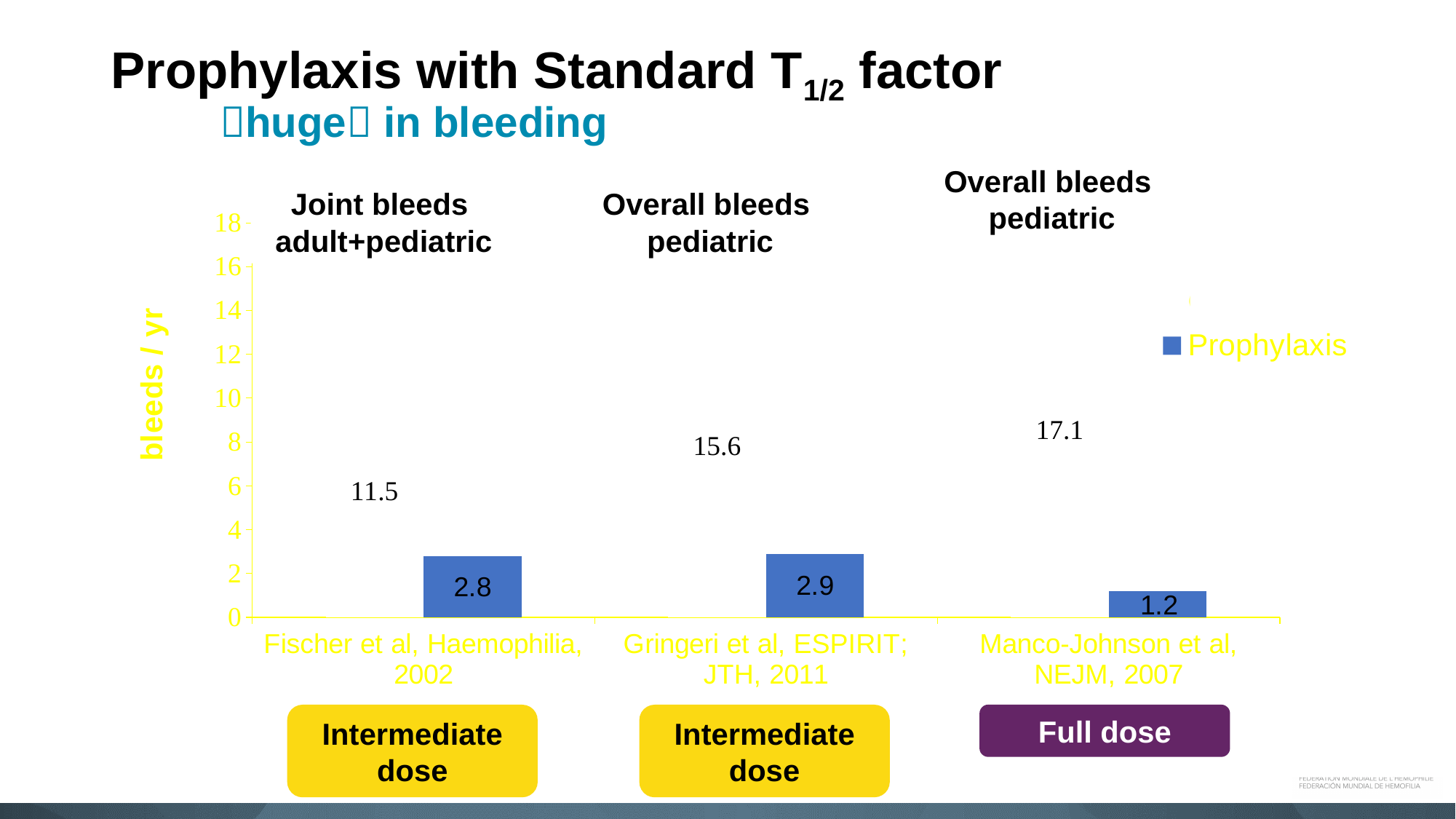
How many series does the chart legend list? 1 What is the Prophylaxis value for Manco-Johnson et al, NEJM, 2007? 1.2 What is the difference between the Prophylaxis values for Gringeri et al, ESPIRIT; JTH, 2011 and Manco-Johnson et al, NEJM, 2007? 1.7 How many studies are shown on the x axis of the chart? 3 Which study has the highest Prophylaxis bar? Gringeri et al, ESPIRIT; JTH, 2011 What kind of chart is shown on the slide? bar chart Is the Prophylaxis value for Manco-Johnson et al, NEJM, 2007 greater or less than 2? less What is the Prophylaxis value for Fischer et al, Haemophilia, 2002? 2.8 What is the label on the y axis of the chart? bleeds / yr Which study has the lowest Prophylaxis bar? Manco-Johnson et al, NEJM, 2007 What is the Prophylaxis value for Gringeri et al, ESPIRIT; JTH, 2011? 2.9 Which is larger, the Prophylaxis value for Fischer et al, Haemophilia, 2002 or for Manco-Johnson et al, NEJM, 2007? Fischer et al, Haemophilia, 2002